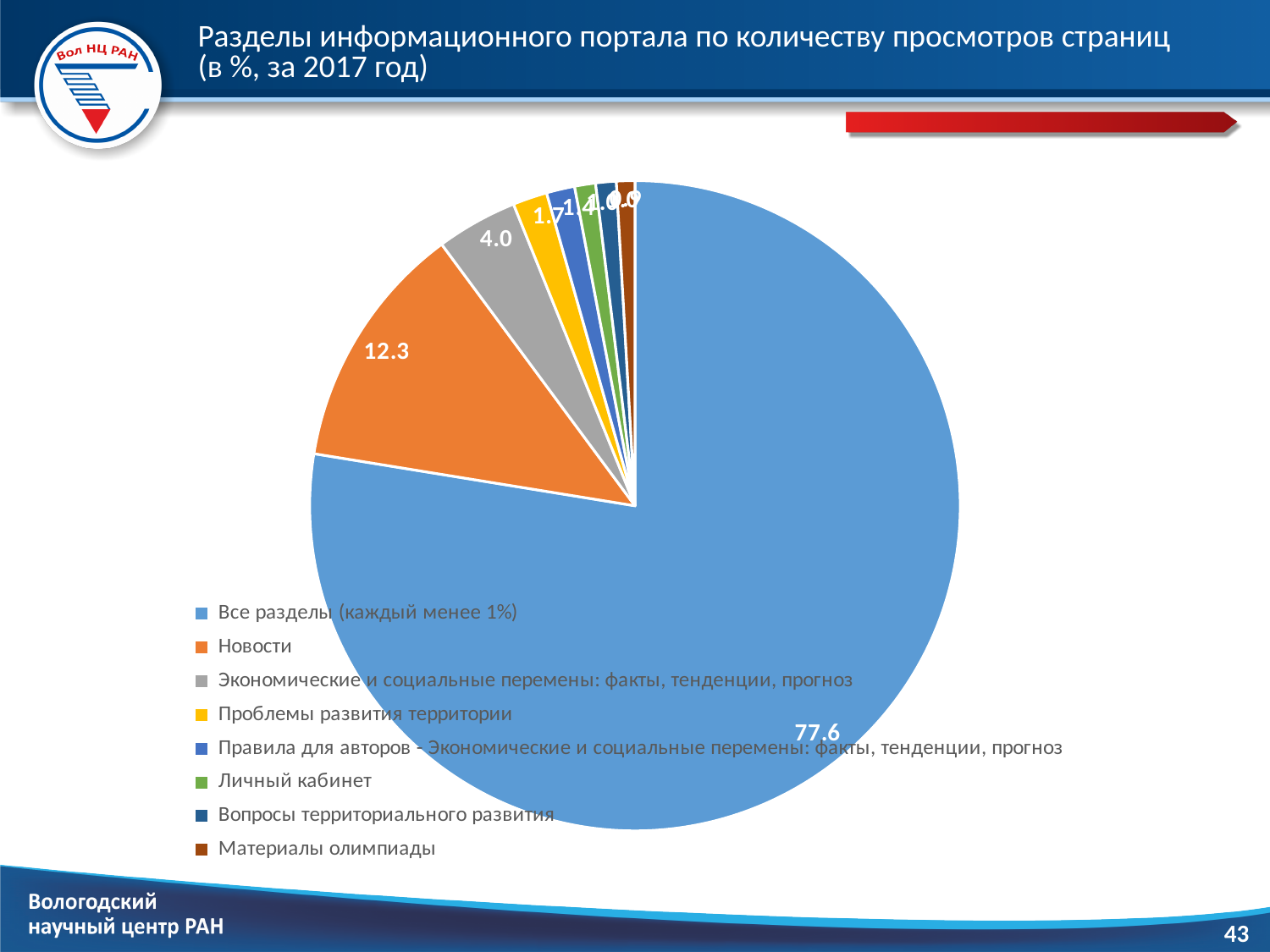
What is the difference between the values for Новости and Экономические и социальные перемены: факты, тенденции, прогноз? 8.3 How many categories does the legend of the pie chart list? 8 What is the value shown for Экономические и социальные перемены: факты, тенденции, прогноз? 4.0 What colour is the slice for Новости? orange Which category has the largest slice of the pie chart? Все разделы (каждый менее 1%) What is the difference between the values for Все разделы (каждый менее 1%) and Новости? 65.3 What kind of chart is shown on the slide? pie chart What is the value shown for Новости? 12.3 What is the title of the slide containing the pie chart? Разделы информационного портала по количеству просмотров страниц (в %, за 2017 год) What is the value shown for Проблемы развития территории? 1.7 What is the value shown for Все разделы (каждый менее 1%)? 77.6 Which is larger, the value for Новости or the value for Проблемы развития территории? Новости